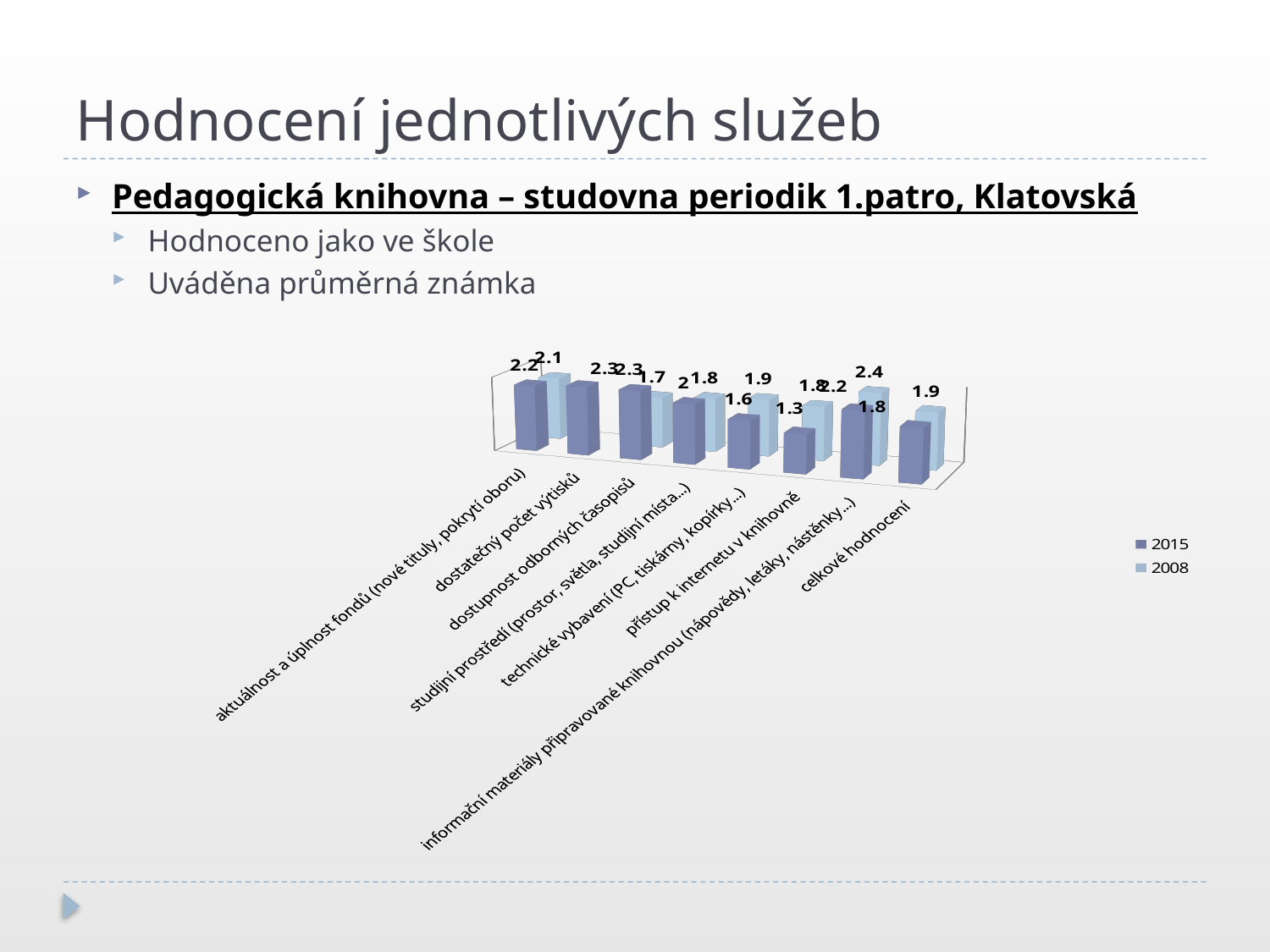
For 'aktuálnost a úplnost fondů (nové tituly, pokrytí oboru)', which series has the larger value, 2015 or 2008? 2015 What is the difference between the 2015 and 2008 values for 'aktuálnost a úplnost fondů (nové tituly, pokrytí oboru)'? 0.1 Which category has the lowest 2015 value? přístup k internetu v knihovně What kind of chart is shown on the slide? bar chart What is the lowest value labelled on the chart? 1.3 What is the 2008 value for 'celkové hodnocení'? 1.9 What is the 2008 value for 'aktuálnost a úplnost fondů (nové tituly, pokrytí oboru)'? 2.1 Which years are listed in the chart legend? 2015 and 2008 What is the 2015 value for 'aktuálnost a úplnost fondů (nové tituly, pokrytí oboru)'? 2.2 How many series does the chart legend list? 2 How many categories are shown on the chart's x axis? 8 What is the 2015 value for 'přístup k internetu v knihovně'? 1.3